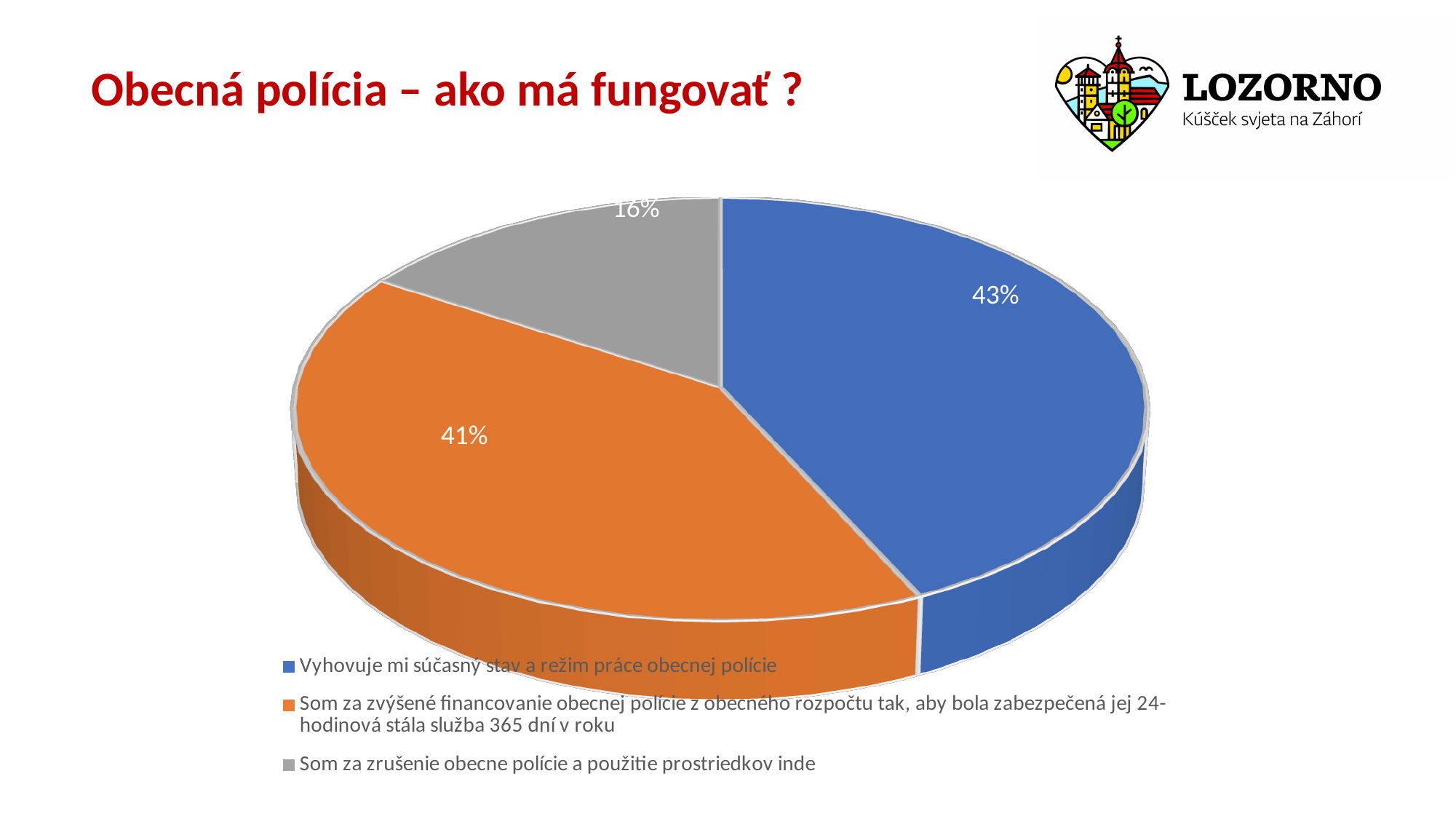
Which category has the smallest slice of the pie? Som za zrušenie obecne polície a použitie prostriedkov inde What share of the pie is labelled for "Som za zvýšené financovanie obecnej polície z obecného rozpočtu tak, aby bola zabezpečená jej 24-hodinová stála služba 365 dní v roku"? 41% How many entries does the legend list? 3 How many slices does the pie chart have? 3 What share of the pie is labelled for "Vyhovuje mi súčasný stav a režim práce obecnej polície"? 43% Which category has the largest slice of the pie? Vyhovuje mi súčasný stav a režim práce obecnej polície What is the difference in percentage points between the 43% slice and the 16% slice? 27 What kind of chart is shown on the slide? pie chart Which is larger: the slice for "Vyhovuje mi súčasný stav a režim práce obecnej polície" or the slice for "Som za zrušenie obecne polície a použitie prostriedkov inde"? Vyhovuje mi súčasný stav a režim práce obecnej polície What colour is the slice for "Som za zrušenie obecne polície a použitie prostriedkov inde"? grey What share of the pie is labelled for "Som za zrušenie obecne polície a použitie prostriedkov inde"? 16% What is the title of the slide containing the chart? Obecná polícia – ako má fungovať ?